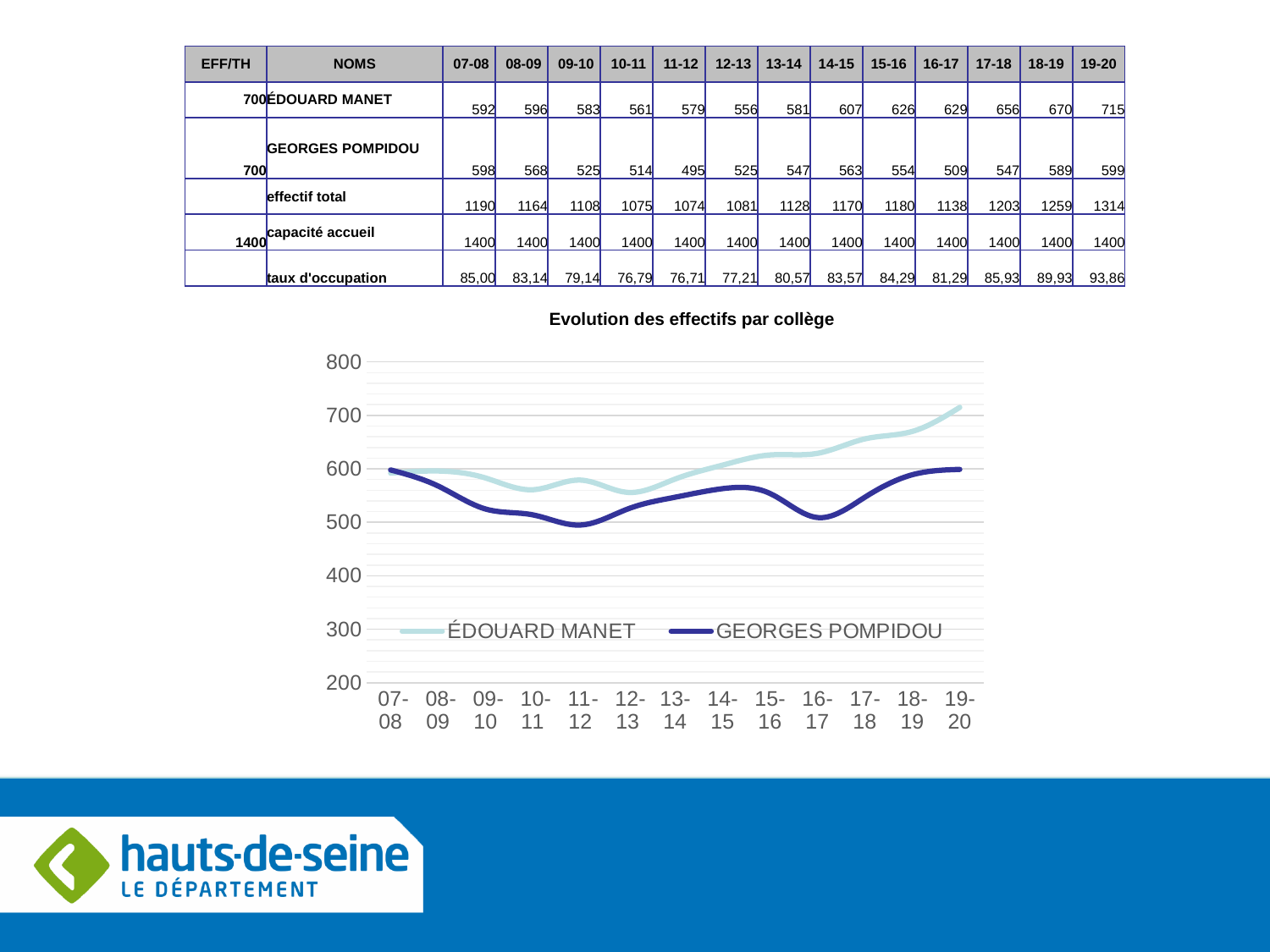
Is the value for GEORGES POMPIDOU in 16-17 greater or less than 600? less What kind of chart is shown under the title 'Evolution des effectifs par collège'? line chart How many series does the legend of the chart list? 2 What is the value for GEORGES POMPIDOU in 11-12? 495 Does the ÉDOUARD MANET line rise or fall from 14-15 to 19-20? rise In which school year does GEORGES POMPIDOU reach its lowest value? 11-12 In which school year does ÉDOUARD MANET reach its highest value? 19-20 What is the value for ÉDOUARD MANET in 19-20? 715 Which series has the higher value in 19-20, ÉDOUARD MANET or GEORGES POMPIDOU? ÉDOUARD MANET How many school years are plotted along the x axis of the chart? 13 Is the value for ÉDOUARD MANET in 19-20 greater or less than 700? greater What is the difference between ÉDOUARD MANET and GEORGES POMPIDOU in 19-20? 116